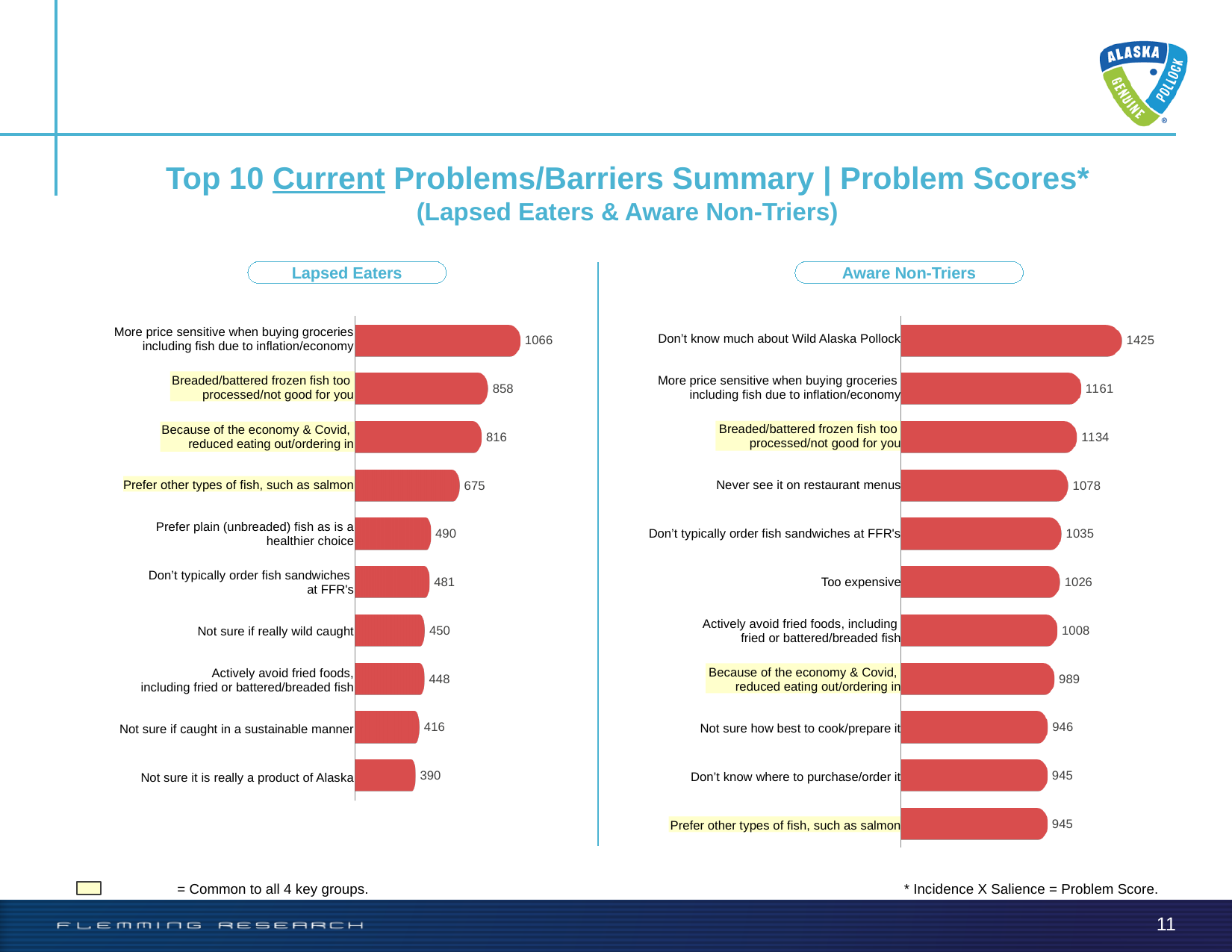
Which has a higher problem score: "Breaded/battered frozen fish too processed/not good for you" in the Lapsed Eaters chart or in the Aware Non-Triers chart? Aware Non-Triers In the Lapsed Eaters chart, which problem has the highest score? More price sensitive when buying groceries including fish due to inflation/economy How many problems are listed in the Lapsed Eaters chart? 10 In the Aware Non-Triers chart, which problem has the highest score? Don't know much about Wild Alaska Pollock In the Lapsed Eaters chart, what is the difference between the scores for "Breaded/battered frozen fish too processed/not good for you" and "Prefer other types of fish, such as salmon"? 183 In the Aware Non-Triers chart, what is the problem score for "Never see it on restaurant menus"? 1078 In the Aware Non-Triers chart, what is the difference between the scores for "Don't know much about Wild Alaska Pollock" and "Too expensive"? 399 How many problems are listed in the Aware Non-Triers chart? 11 What type of chart is used for the Aware Non-Triers data? Bar chart In the Lapsed Eaters chart, what is the problem score for "Not sure if really wild caught"? 450 In the Lapsed Eaters chart, which problem has the lowest score? Not sure it is really a product of Alaska In the Aware Non-Triers chart, what is the problem score for "Not sure how best to cook/prepare it"? 946